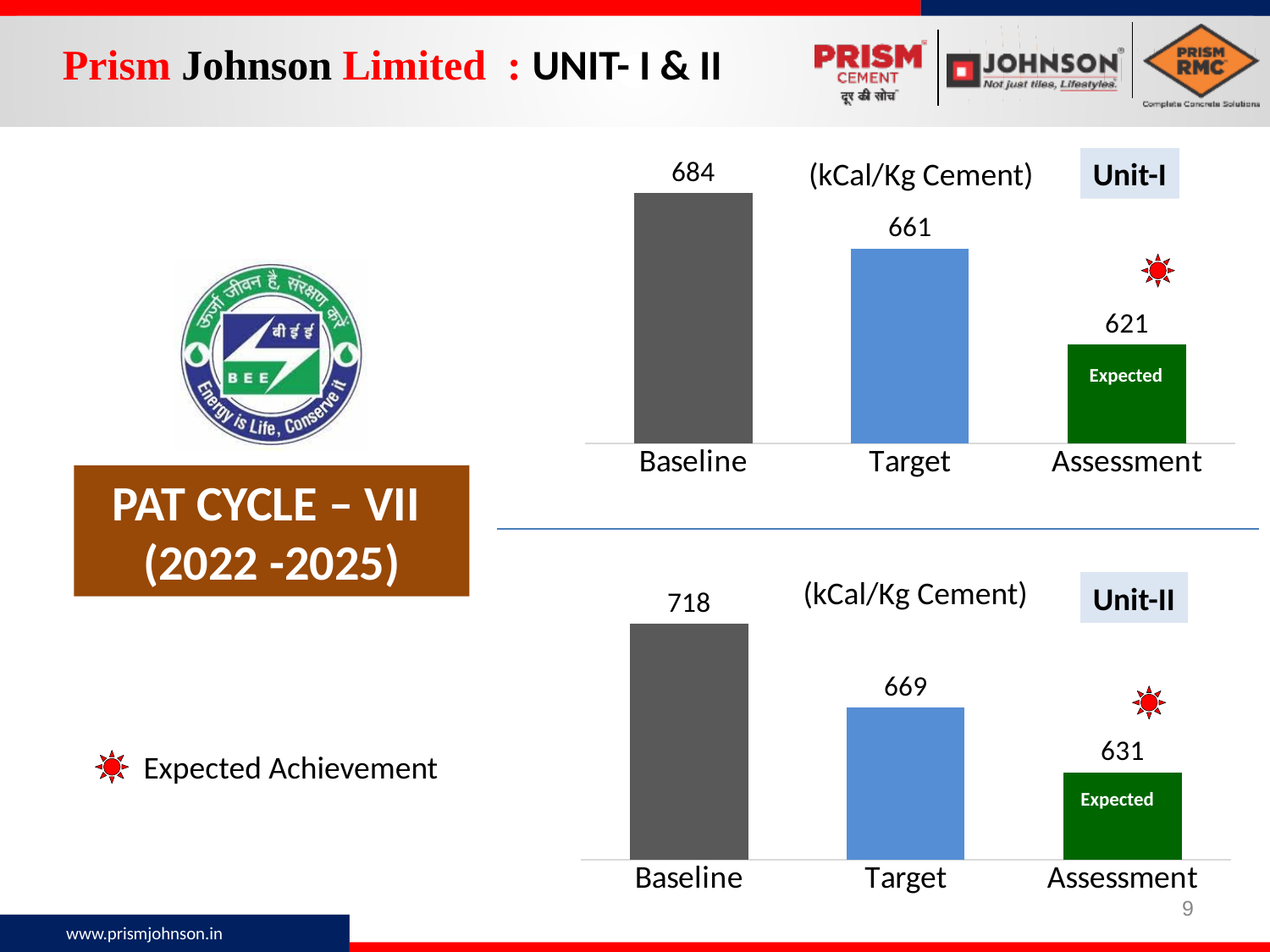
In the Unit-II chart, what is the value for Baseline? 718 In the Unit-II chart, what is the value for Target? 669 In the Unit-I chart, what is the value for Baseline? 684 What type of chart is the Unit-I chart? bar chart In the Unit-II chart, what is the value for Assessment? 631 In the Unit-I chart, what is the difference between the Baseline and Assessment values? 63 In the Unit-I chart, what is the value for Assessment? 621 In the Unit-I chart, what is the value for Target? 661 In the Unit-II chart, which category has the lowest value? Assessment In the Unit-I chart, which category has the highest value? Baseline In the Unit-II chart, do the values rise or fall from Baseline to Assessment? fall In the Unit-II chart, what is the difference between the Target and Assessment values? 38